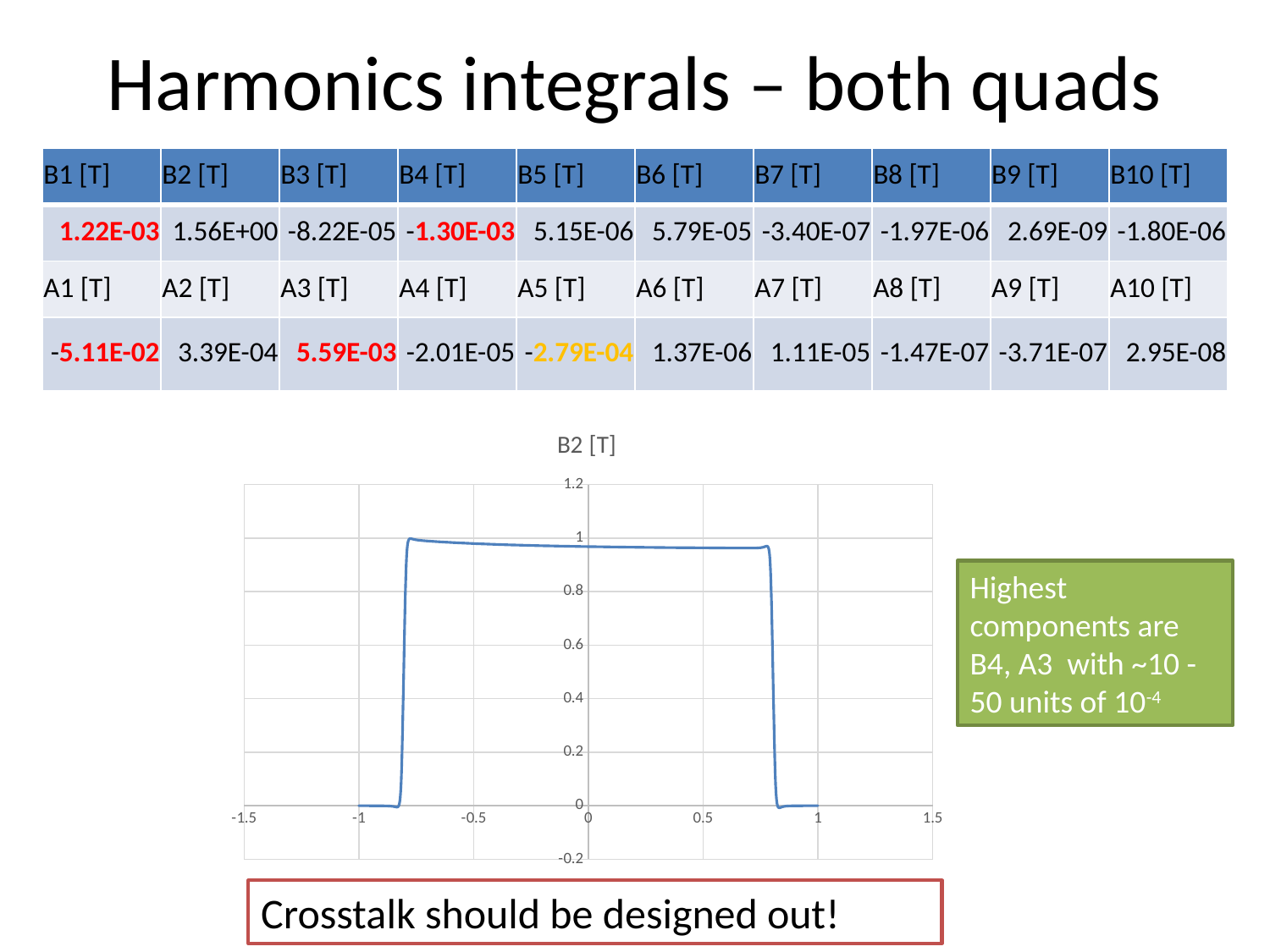
Is the value of the line at x = 0 greater or less than 1.2? less Is the value of the line at x = 0 greater or less than 0.8? greater What kind of chart is shown on the slide? line chart What is the title of the chart? B2 [T] Is the value of the line at x = -1 greater or less than 0.2? less Does the line rise or fall as x goes from -1 to -0.5? rise What is the highest tick value shown on the y axis? 1.2 Does the line rise or fall as x goes from 0.5 to 1? fall What is the lowest tick value shown on the x axis? -1.5